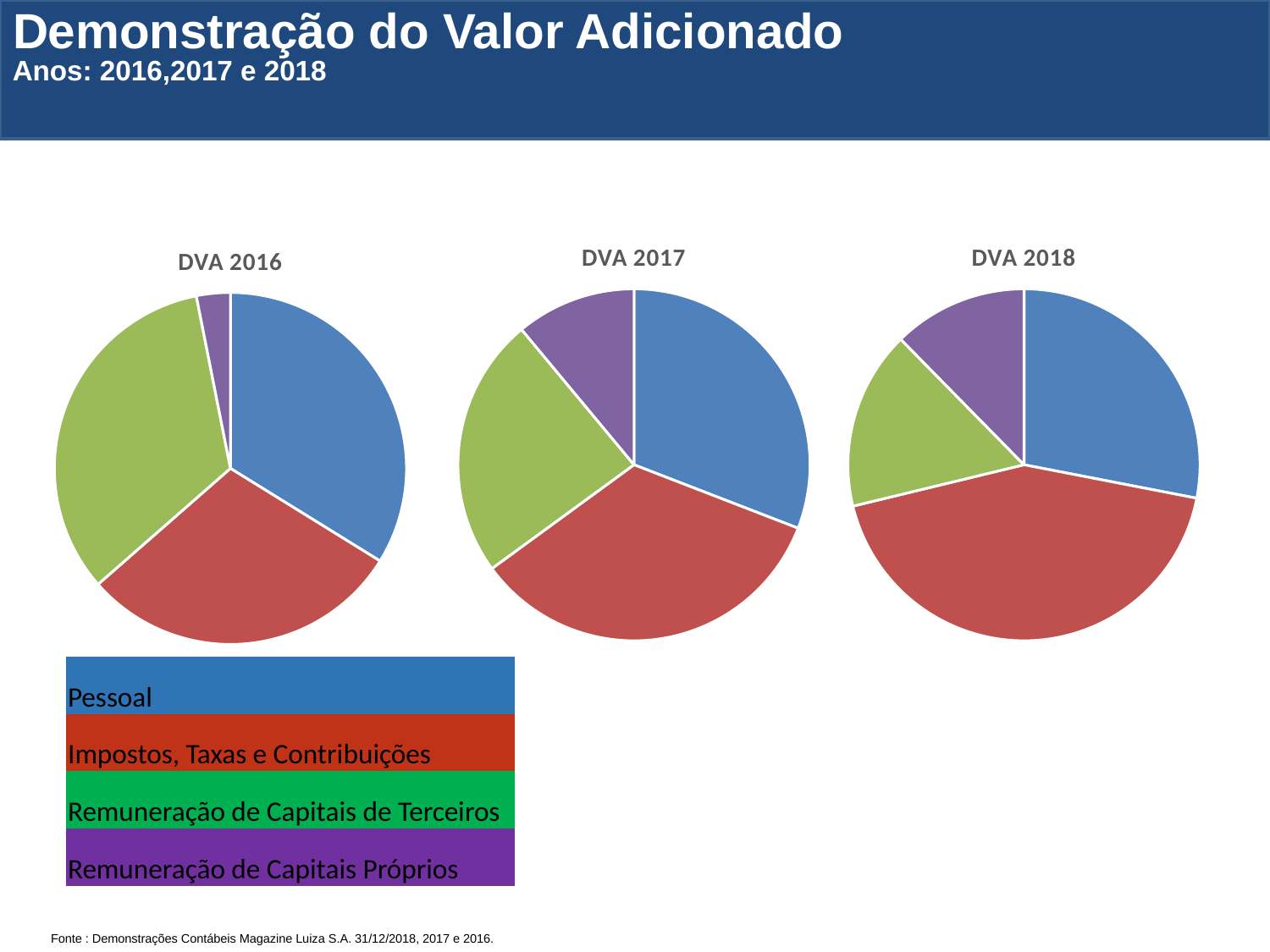
What are the titles of the three pie charts on the slide? DVA 2016, DVA 2017, DVA 2018 Does the Remuneração de Capitais de Terceiros slice grow or shrink from DVA 2016 to DVA 2018? shrink In the DVA 2017 chart, which category has the smallest slice? Remuneração de Capitais Próprios Which category is shown in blue in the pie charts? Pessoal How many slices does the DVA 2018 pie chart have? 4 In the DVA 2018 chart, which category has the largest slice? Impostos, Taxas e Contribuições In the DVA 2017 chart, which slice is larger: Remuneração de Capitais de Terceiros or Remuneração de Capitais Próprios? Remuneração de Capitais de Terceiros In the DVA 2018 chart, which slice is larger: Pessoal or Remuneração de Capitais de Terceiros? Pessoal In the DVA 2018 chart, which category has the smallest slice? Remuneração de Capitais Próprios What kind of chart is DVA 2016? pie chart How many categories does the legend list? 4 In the DVA 2016 chart, which category has the smallest slice? Remuneração de Capitais Próprios